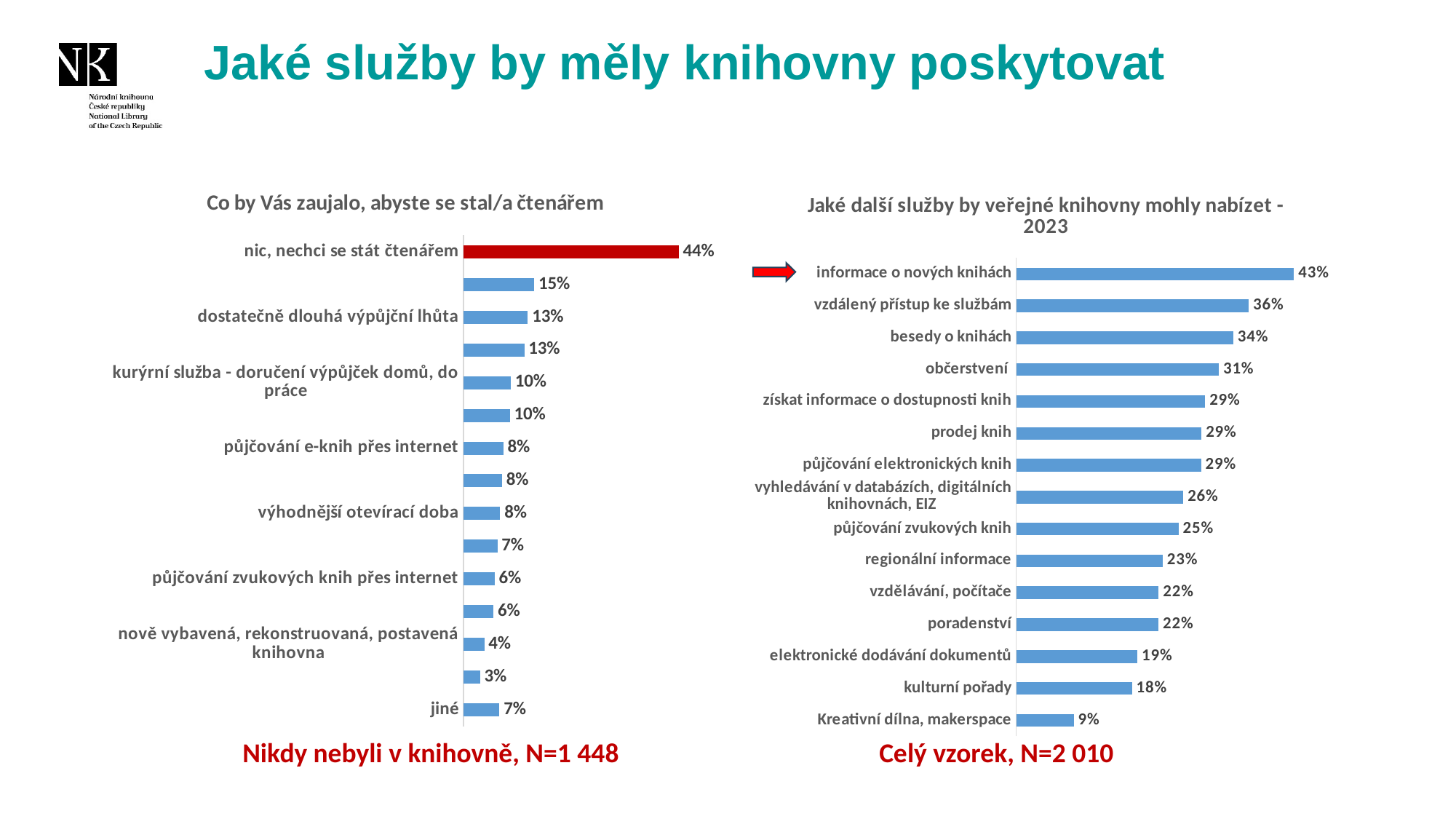
In the chart 'Jaké další služby by veřejné knihovny mohly nabízet - 2023', what is the value for 'Kreativní dílna, makerspace'? 9% In the chart 'Co by Vás zaujalo, abyste se stal/a čtenářem', what is the difference between 'nic, nechci se stát čtenářem' and 'dostatečně dlouhá výpůjční lhůta'? 31% In the chart 'Co by Vás zaujalo, abyste se stal/a čtenářem', which category has the highest value? nic, nechci se stát čtenářem How many categories are shown in the chart 'Jaké další služby by veřejné knihovny mohly nabízet - 2023'? 15 In the chart 'Jaké další služby by veřejné knihovny mohly nabízet - 2023', which is larger: 'besedy o knihách' or 'občerstvení'? besedy o knihách In the chart 'Co by Vás zaujalo, abyste se stal/a čtenářem', what is the value for 'jiné'? 7% In the chart 'Jaké další služby by veřejné knihovny mohly nabízet - 2023', what is the value for 'vzdálený přístup ke službám'? 36% What type of chart is the chart on the right of the slide? bar chart In the chart 'Co by Vás zaujalo, abyste se stal/a čtenářem', what is the value for 'nic, nechci se stát čtenářem'? 44% In the chart 'Co by Vás zaujalo, abyste se stal/a čtenářem', what is the value for 'dostatečně dlouhá výpůjční lhůta'? 13% In the chart 'Jaké další služby by veřejné knihovny mohly nabízet - 2023', what is the difference between 'informace o nových knihách' and 'kulturní pořady'? 25% In the chart 'Jaké další služby by veřejné knihovny mohly nabízet - 2023', which category has the lowest value? Kreativní dílna, makerspace